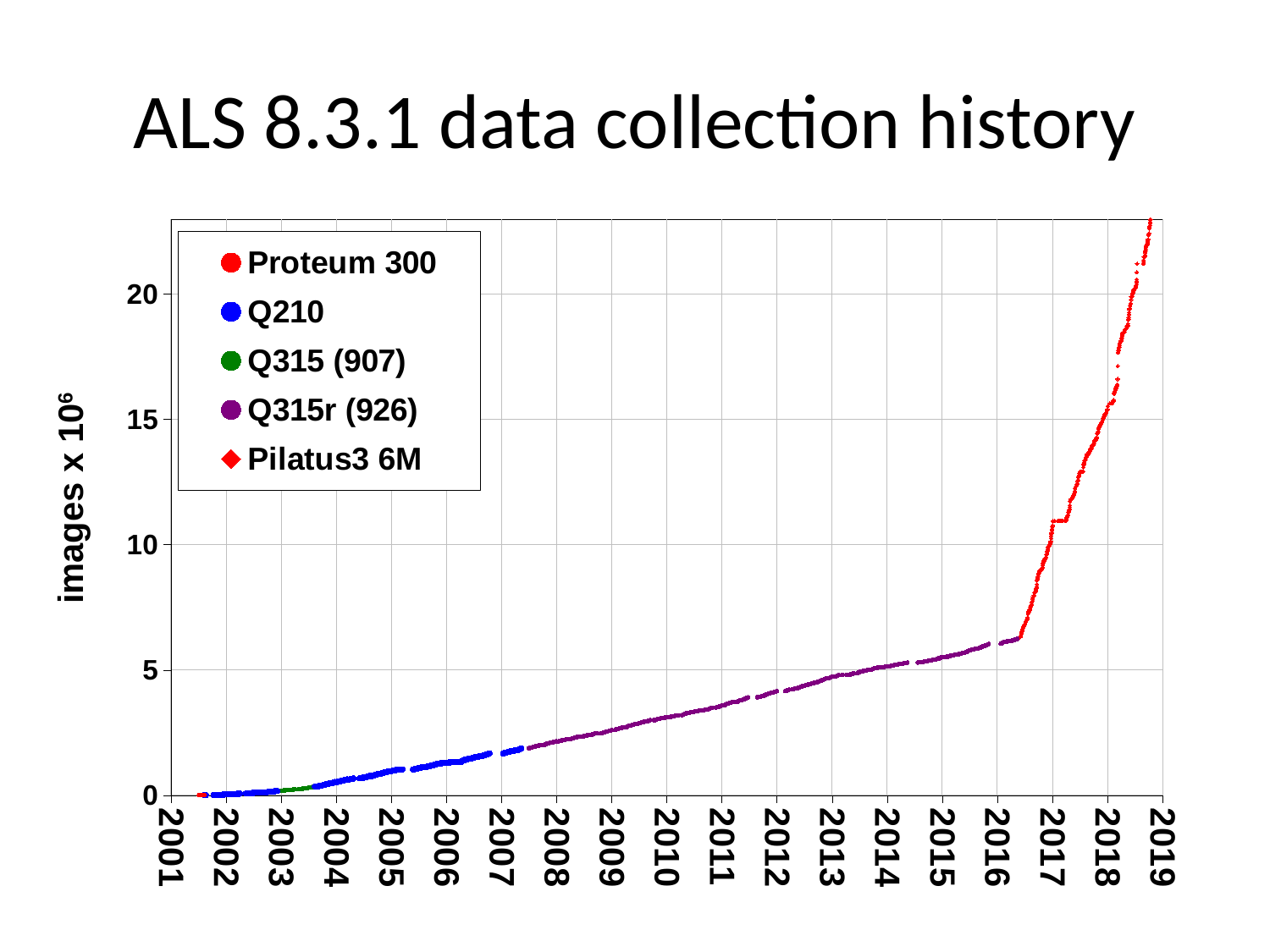
Do the plotted values rise or fall as the years increase along the x axis? rise Is the value at the start of 2010 greater or less than 5? less What kind of chart is shown on the slide? scatter chart Is the value at the start of 2012 greater or less than 5? less Is the value at the start of 2016 greater or less than 5? greater Which series reaches the highest values on the chart? Pilatus3 6M What is the title of the chart? ALS 8.3.1 data collection history How many series does the legend list? 5 Which series has the lowest values on the chart? Proteum 300 What is the label of the y axis? images x 10^6